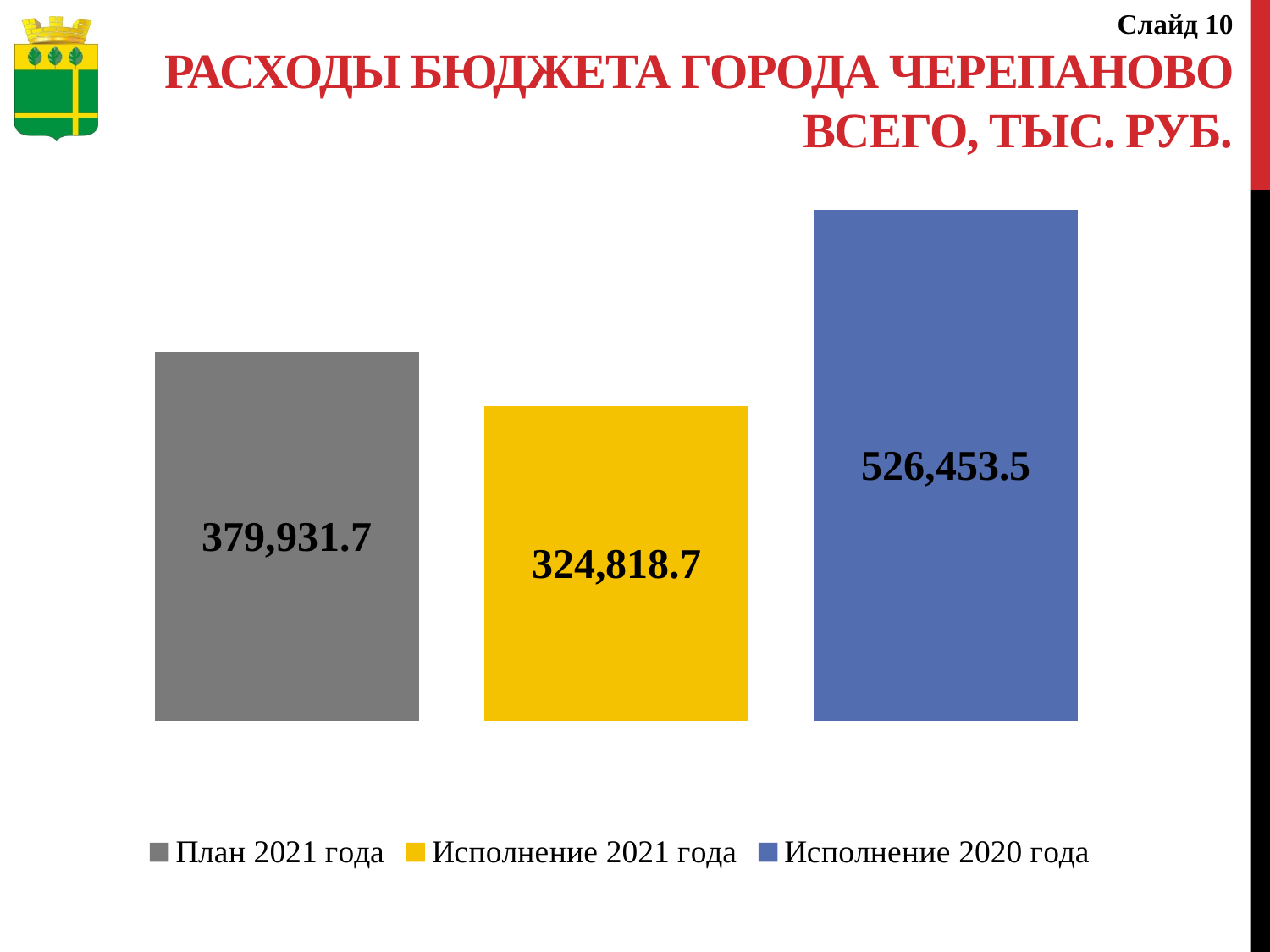
Which series has the lowest value? Исполнение 2021 года What is the value for Исполнение 2021 года? 324,818.7 What is the difference between План 2021 года and Исполнение 2021 года? 55,113.0 What is the value for Исполнение 2020 года? 526,453.5 How many bars are plotted on the chart? 3 What colour is the bar for Исполнение 2021 года? Yellow Which series has the highest value? Исполнение 2020 года What is the difference between Исполнение 2020 года and Исполнение 2021 года? 201,634.8 What kind of chart is shown on the slide? Bar chart What is the value for План 2021 года? 379,931.7 How many series does the legend list? 3 Which is larger, План 2021 года or Исполнение 2020 года? Исполнение 2020 года